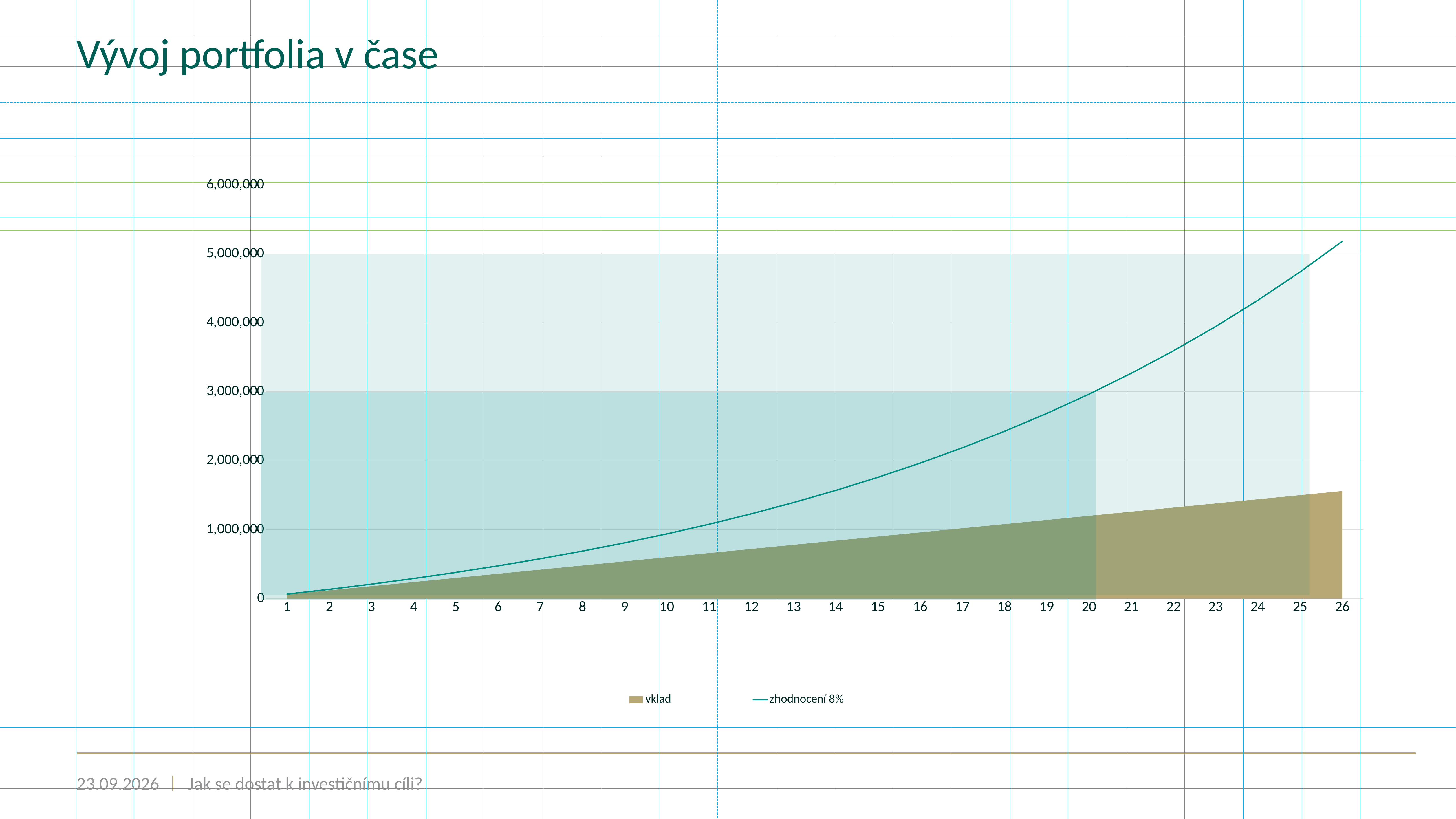
How many series does the chart legend list? 2 Does the 'zhodnocení 8%' line rise or fall as the x axis goes from 1 to 26? rises Does the 'vklad' series rise or fall along the x axis? rises Is the value of 'zhodnocení 8%' at point 10 greater or less than 1,000,000? less What are the two series named in the legend? vklad and zhodnocení 8% At which x-axis point does the 'zhodnocení 8%' series reach its highest value? 26 What kind of chart is used for the 'zhodnocení 8%' series? line chart How many points are shown along the x axis of the chart? 26 Is the value of 'zhodnocení 8%' at point 26 greater or less than 5,000,000? greater What is the title of the chart on the slide? Vývoj portfolia v čase Is the value of 'vklad' at point 26 greater or less than 1,000,000? greater At point 26, which series has the larger value, 'vklad' or 'zhodnocení 8%'? zhodnocení 8%